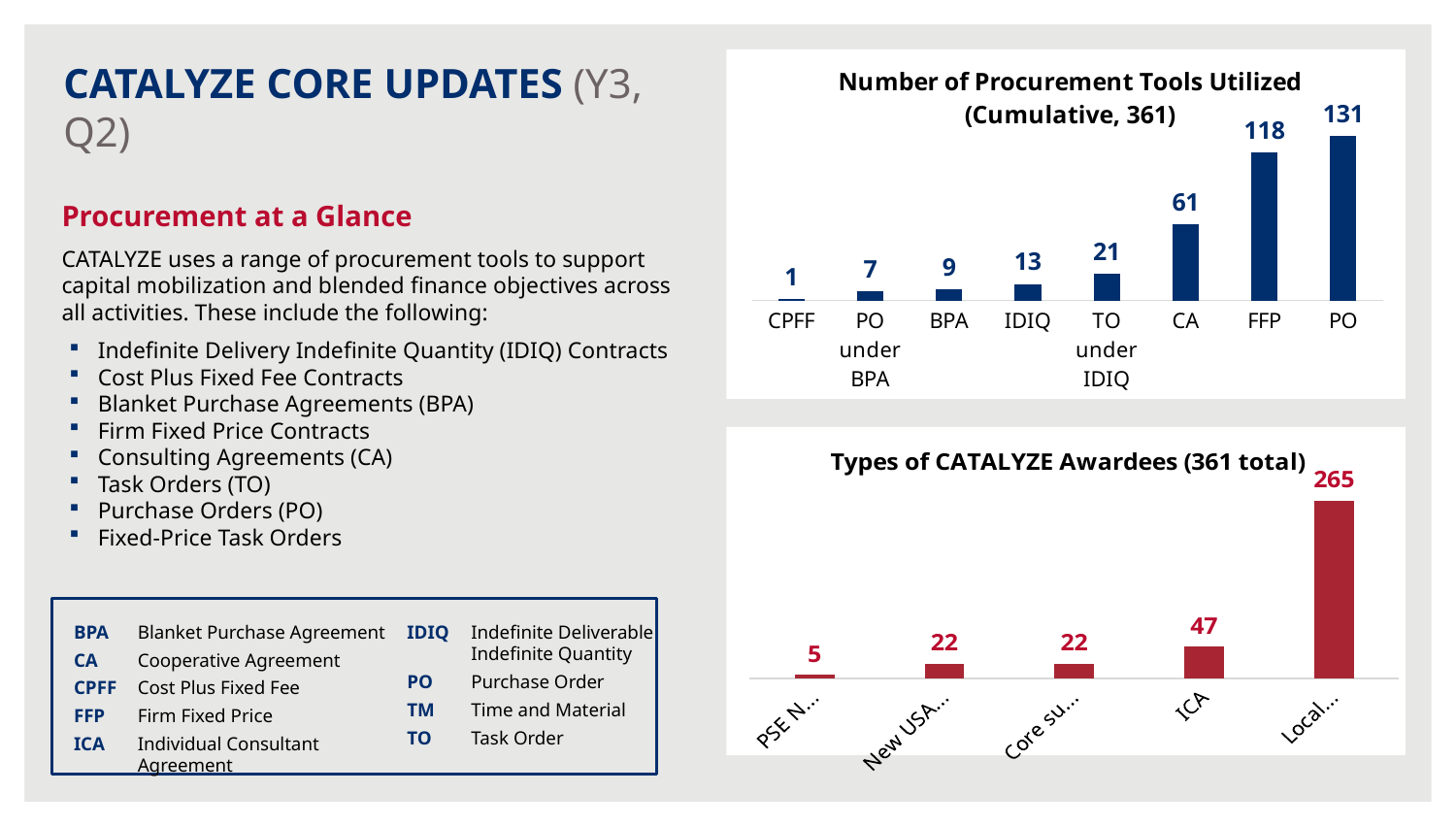
In the 'Number of Procurement Tools Utilized' chart, which category has the highest value? PO How many categories are shown in the 'Number of Procurement Tools Utilized' chart? 8 In the 'Types of CATALYZE Awardees' chart, what is the largest value shown? 265 In the 'Number of Procurement Tools Utilized' chart, which is larger, BPA or IDIQ? IDIQ In the 'Number of Procurement Tools Utilized' chart, what is the value for FFP? 118 In the 'Number of Procurement Tools Utilized' chart, what is the value for TO under IDIQ? 21 In the 'Number of Procurement Tools Utilized' chart, what is the difference between PO and FFP? 13 In the 'Number of Procurement Tools Utilized' chart, what is the value for CA? 61 In the 'Number of Procurement Tools Utilized' chart, which category has the lowest value? CPFF In the 'Types of CATALYZE Awardees' chart, what is the value for ICA? 47 What kind of chart is 'Number of Procurement Tools Utilized'? Bar chart How many bars are shown in the 'Types of CATALYZE Awardees' chart? 5